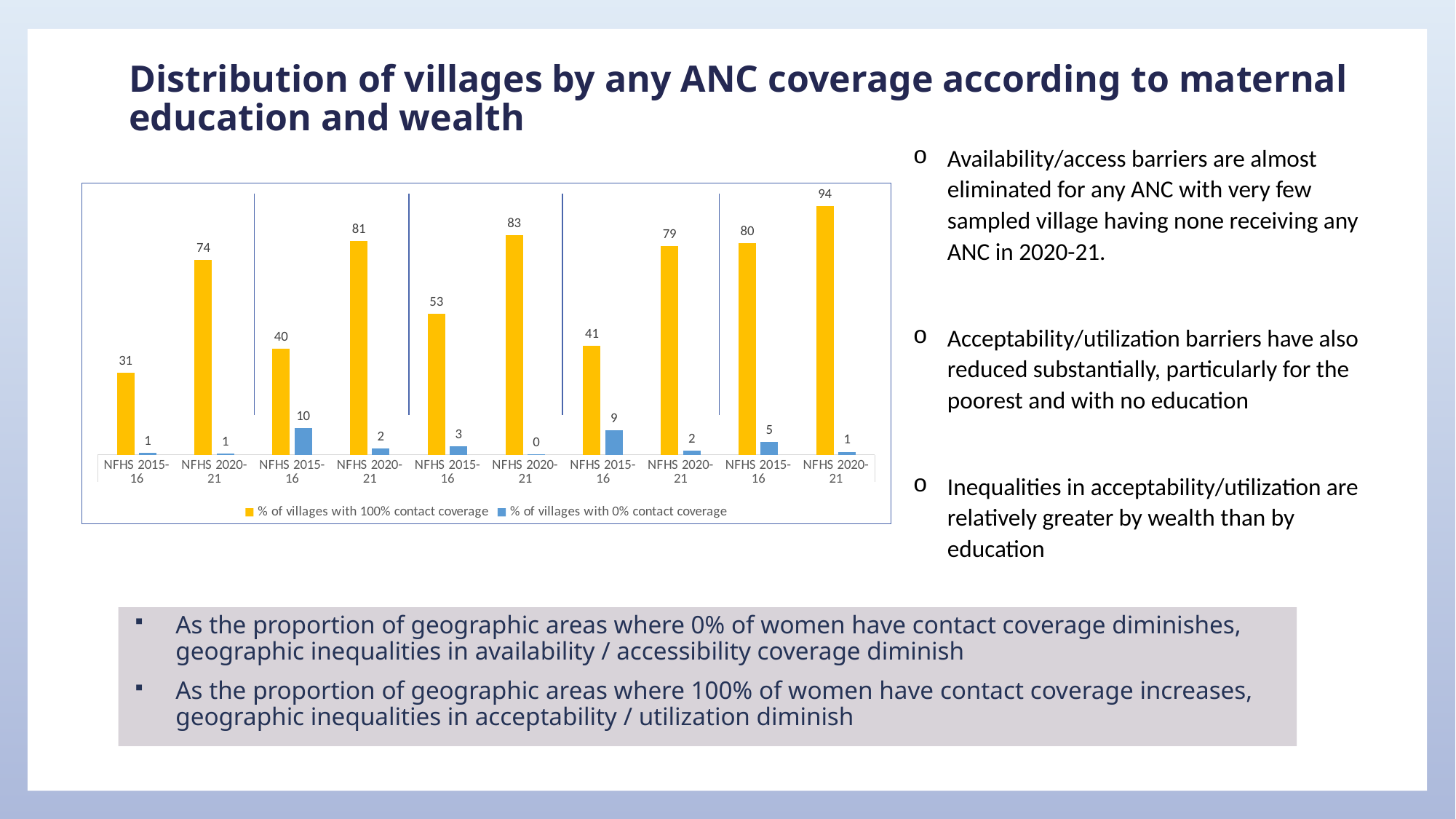
How many series does the chart legend list? 2 What is the highest value among the '% of villages with 0% contact coverage' bars? 10 What is the '% of villages with 0% contact coverage' value for the rightmost NFHS 2020-21 category? 1 In the leftmost group (first NFHS 2015-16 and NFHS 2020-21 pair), what is the difference between the '% of villages with 100% contact coverage' values? 43 What is the lowest value among the '% of villages with 100% contact coverage' bars? 31 In the rightmost group (last NFHS 2015-16 and NFHS 2020-21 pair), what is the difference between the '% of villages with 100% contact coverage' values? 14 What kind of chart is shown on the slide? Bar chart What colour are the '% of villages with 100% contact coverage' bars? Yellow What is the lowest value among the '% of villages with 0% contact coverage' bars? 0 What is the '% of villages with 100% contact coverage' value for the leftmost NFHS 2015-16 category? 31 What is the highest value among the '% of villages with 100% contact coverage' bars? 94 How many categories (x-axis labels) are shown along the bottom of the chart? 10